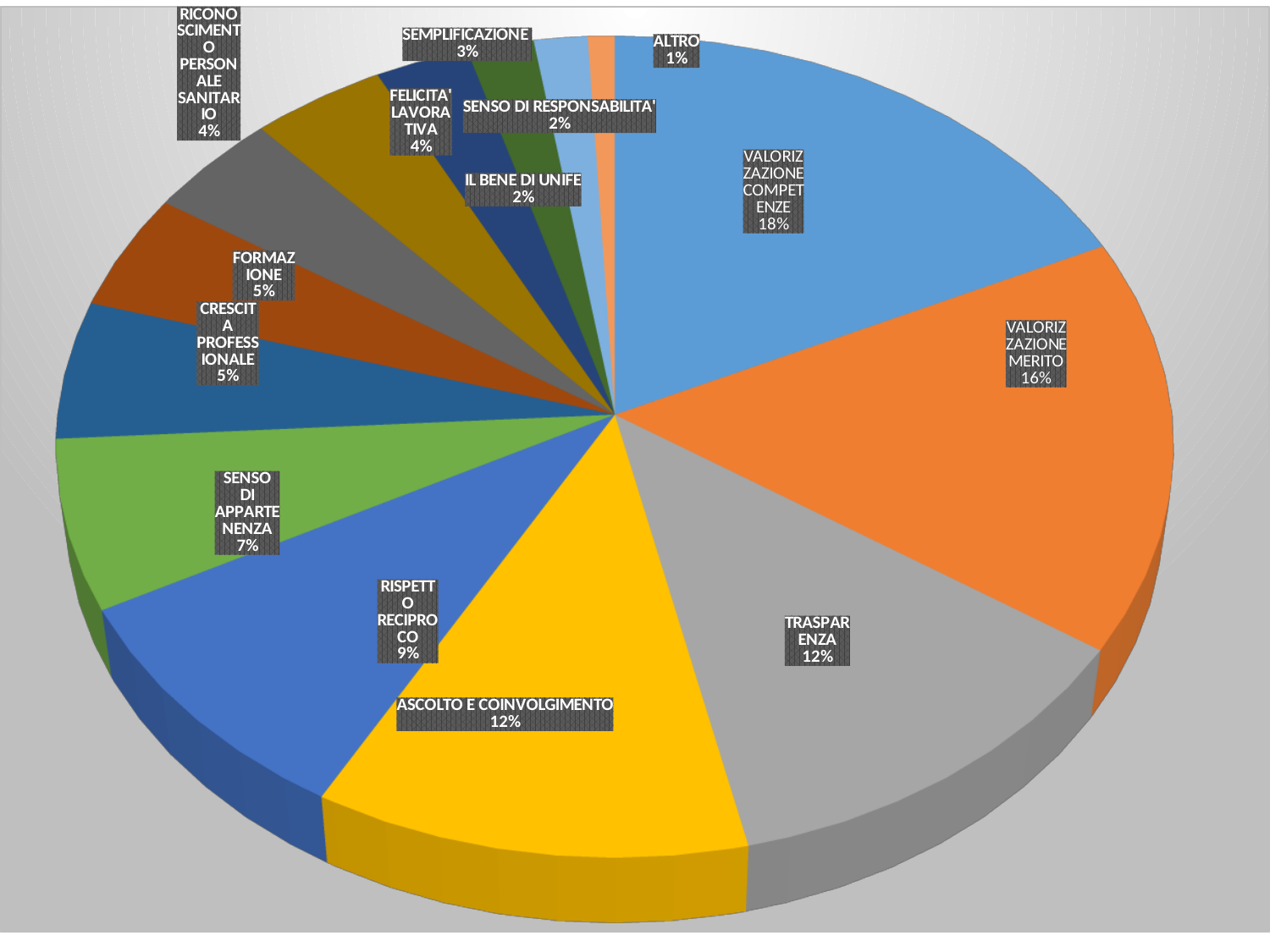
What percentage is shown for TRASPARENZA? 12% Which slice of the pie chart is the largest? VALORIZZAZIONE COMPETENZE What colour is the VALORIZZAZIONE MERITO slice? orange What is the difference in percentage points between VALORIZZAZIONE COMPETENZE and VALORIZZAZIONE MERITO? 2 Which is larger, SENSO DI APPARTENENZA or FORMAZIONE? SENSO DI APPARTENENZA What percentage is shown for VALORIZZAZIONE COMPETENZE? 18% What percentage is shown for SEMPLIFICAZIONE? 3% What kind of chart is shown on the slide? pie chart What percentage is shown for RISPETTO RECIPROCO? 9% How many slices does the pie chart have? 14 Which slice of the pie chart is the smallest? ALTRO What share of the pie does ASCOLTO E COINVOLGIMENTO represent? 12%